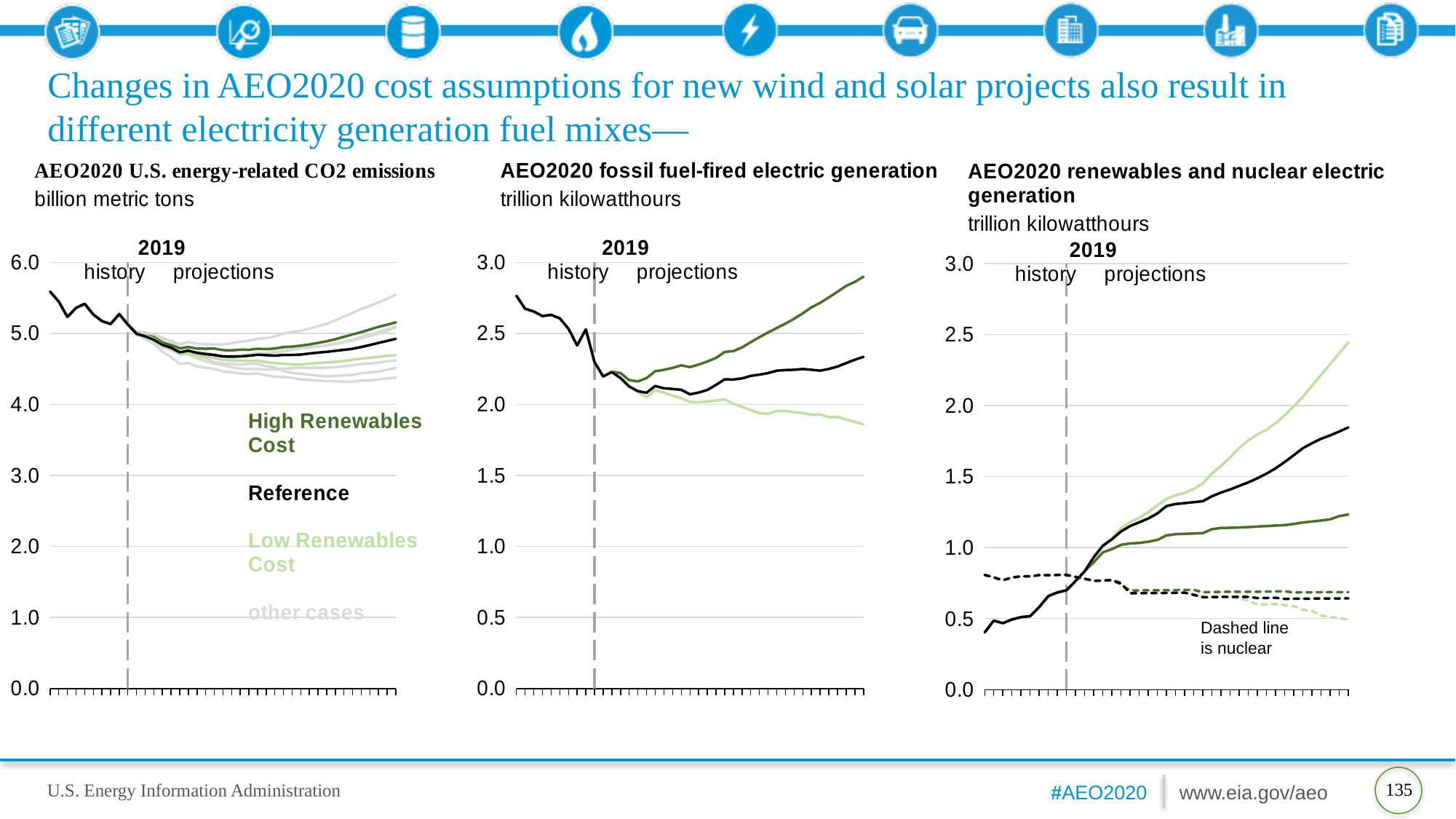
In the AEO2020 renewables and nuclear electric generation chart, is the final projected value of the solid Low Renewables Cost line greater or less than 2.0? greater In the AEO2020 fossil fuel-fired electric generation chart, is the final projected value for the Low Renewables Cost case greater or less than 2.0? less What unit is used on the AEO2020 fossil fuel-fired electric generation chart? trillion kilowatthours In the AEO2020 U.S. energy-related CO2 emissions chart, is the final projected value for the High Renewables Cost case greater or less than 5.0? greater In the AEO2020 renewables and nuclear electric generation chart, what do the dashed lines represent? nuclear In the AEO2020 fossil fuel-fired electric generation chart, does the Low Renewables Cost line rise or fall over the projection period? fall How many charts are shown on the slide? 3 In the AEO2020 renewables and nuclear electric generation chart, do the solid renewables lines rise or fall over the projection period? rise In the AEO2020 fossil fuel-fired electric generation chart, which case ends the projection period higher: High Renewables Cost or Low Renewables Cost? High Renewables Cost What kind of chart is the AEO2020 U.S. energy-related CO2 emissions chart? line chart